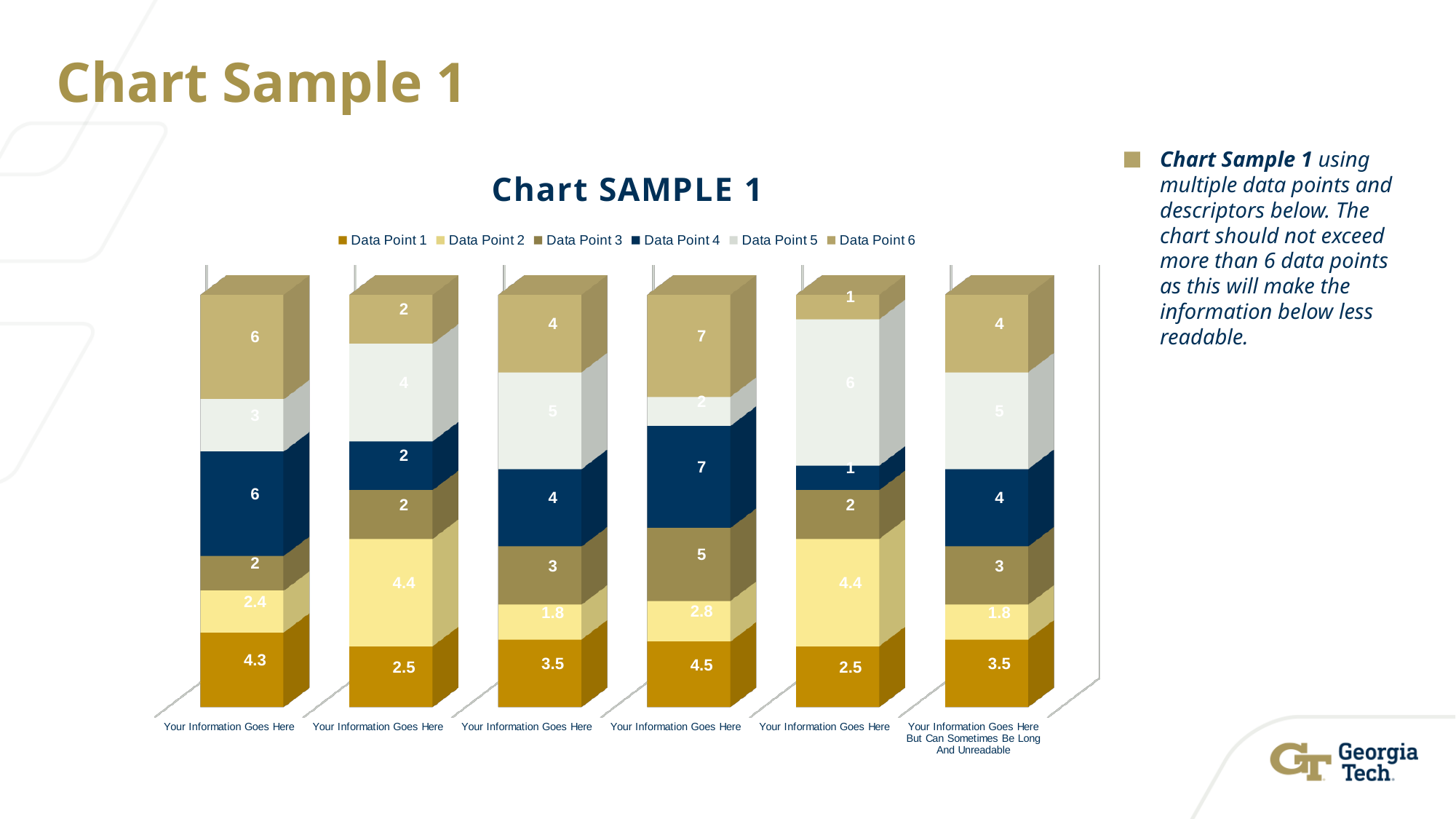
What is the Data Point 5 value for the fifth bar from the left? 6 What is the title of the chart? Chart SAMPLE 1 Which bar has the lowest Data Point 6 value? The fifth bar from the left (1) How many series does the legend list? 6 How many bars (categories) are plotted in the chart? 6 What is the Data Point 1 value for the first (leftmost) bar? 4.3 What is the difference between the Data Point 1 values of the first bar and the second bar? 1.8 What is the total of the stacked values in the fourth bar from the left? 28.3 What is the Data Point 2 value for the second bar from the left? 4.4 Which bar has the highest Data Point 1 value? The fourth bar from the left (4.5) What kind of chart is shown on the slide? Stacked bar chart What is the Data Point 4 value for the fourth bar from the left? 7